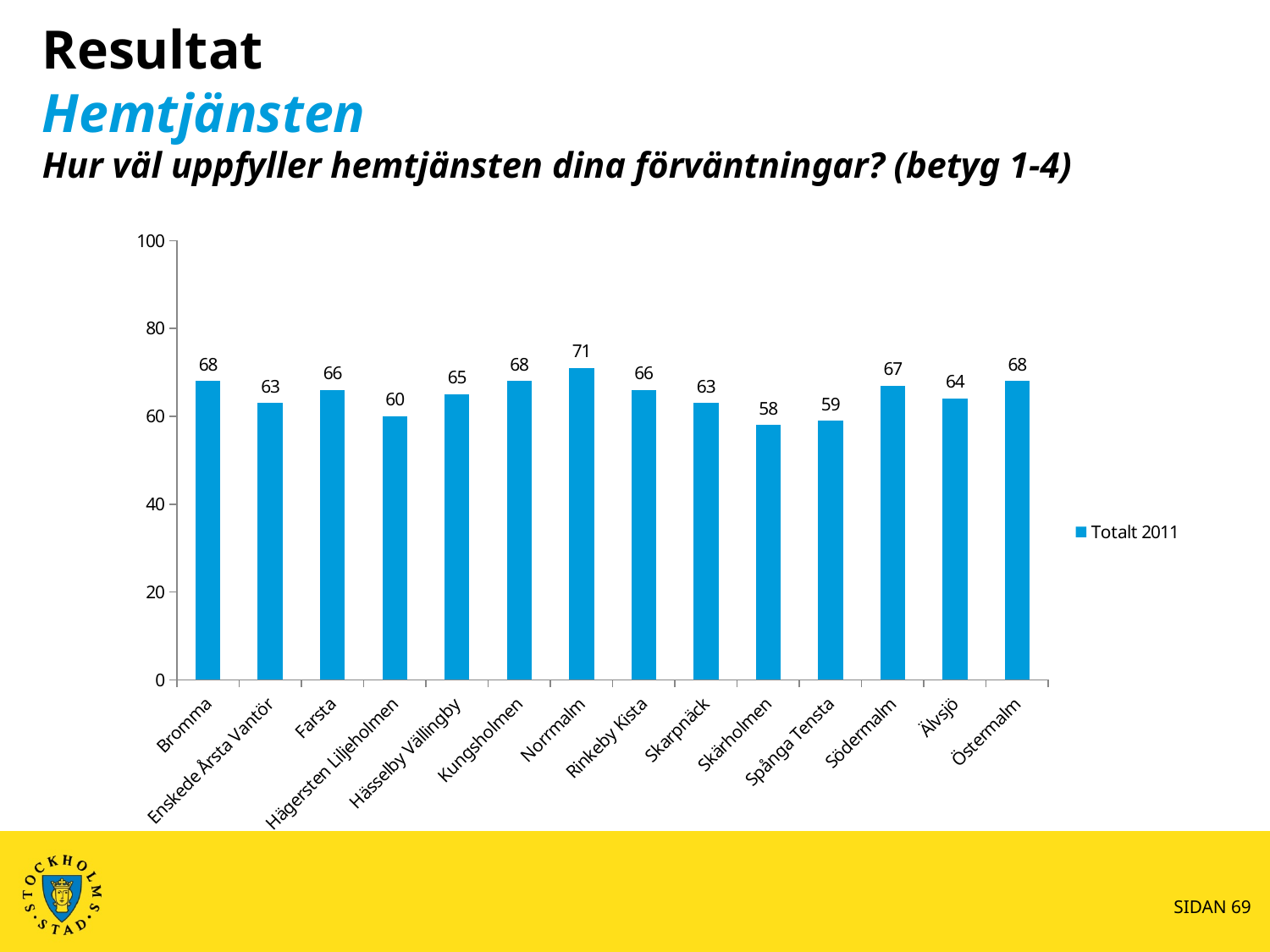
What is the legend entry for the series? Totalt 2011 Which category has the lowest value? Skärholmen How many categories are shown on the x axis? 14 What is the value for Skärholmen? 58 What kind of chart is shown? bar chart Which category has the highest value? Norrmalm Which has a larger value, Södermalm or Älvsjö? Södermalm What is the difference between the values for Norrmalm and Skärholmen? 13 How many series does the legend list? 1 Is the value for Spånga Tensta greater or less than 60? less What is the value for Norrmalm? 71 What is the value for Hägersten Liljeholmen? 60